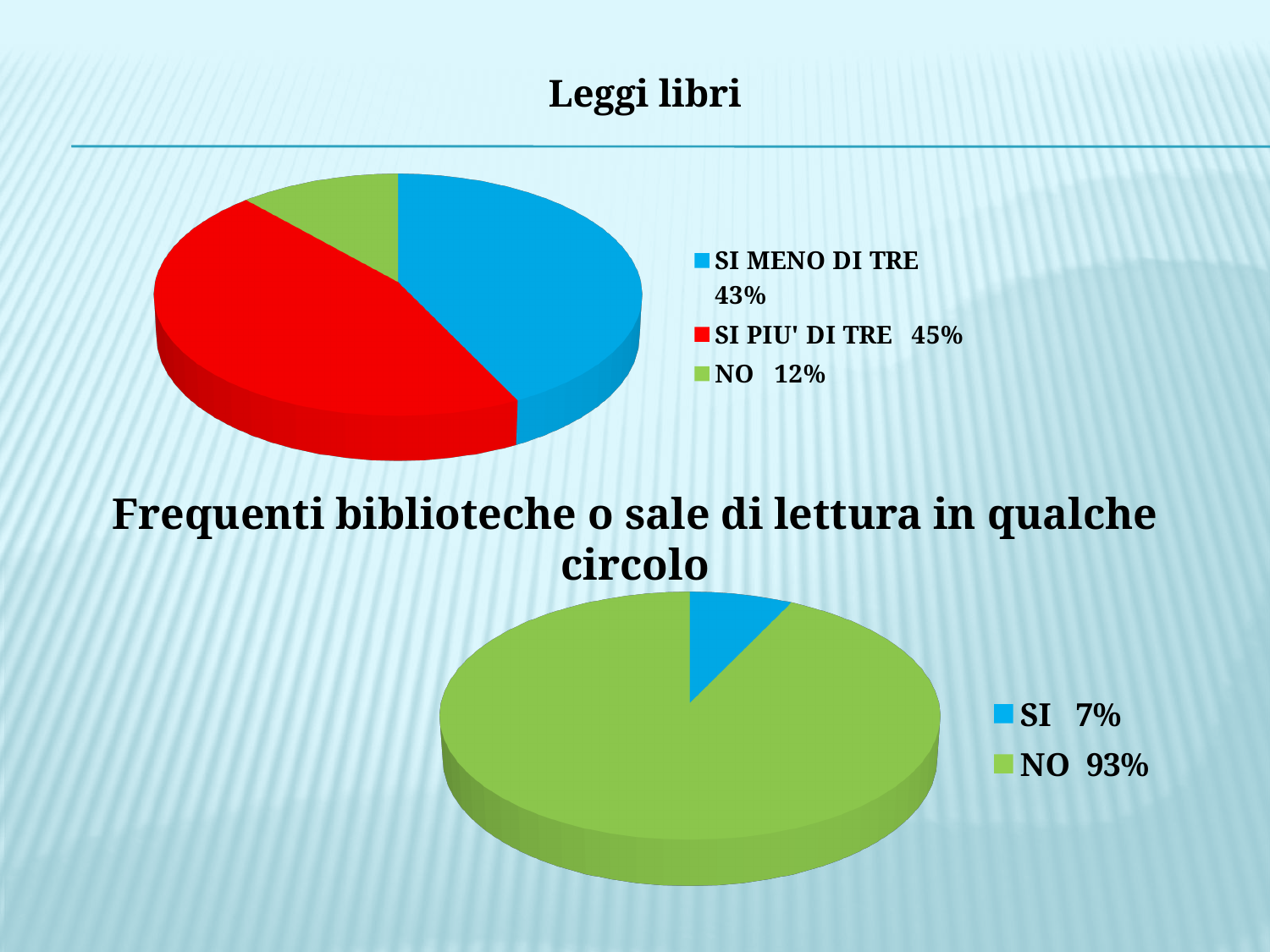
In the 'Leggi libri' chart, what is the difference between 'SI PIU' DI TRE' and 'NO'? 33% What type of chart is the 'Leggi libri' chart? Pie chart In the 'Frequenti biblioteche o sale di lettura in qualche circolo' chart, what percentage is shown for 'SI'? 7% In the 'Frequenti biblioteche o sale di lettura in qualche circolo' chart, which is larger, 'SI' or 'NO'? NO In the 'Leggi libri' chart, what percentage is shown for 'SI MENO DI TRE'? 43% In the 'Leggi libri' chart, what percentage is shown for 'SI PIU' DI TRE'? 45% In the 'Frequenti biblioteche o sale di lettura in qualche circolo' chart, what percentage is shown for 'NO'? 93% In the 'Leggi libri' chart, what percentage is shown for 'NO'? 12% In the 'Frequenti biblioteche o sale di lettura in qualche circolo' chart, what colour is the 'NO' slice? Green In the 'Leggi libri' chart, how many categories does the legend list? 3 In the 'Leggi libri' chart, which category has the largest share? SI PIU' DI TRE In the 'Leggi libri' chart, which category has the smallest share? NO